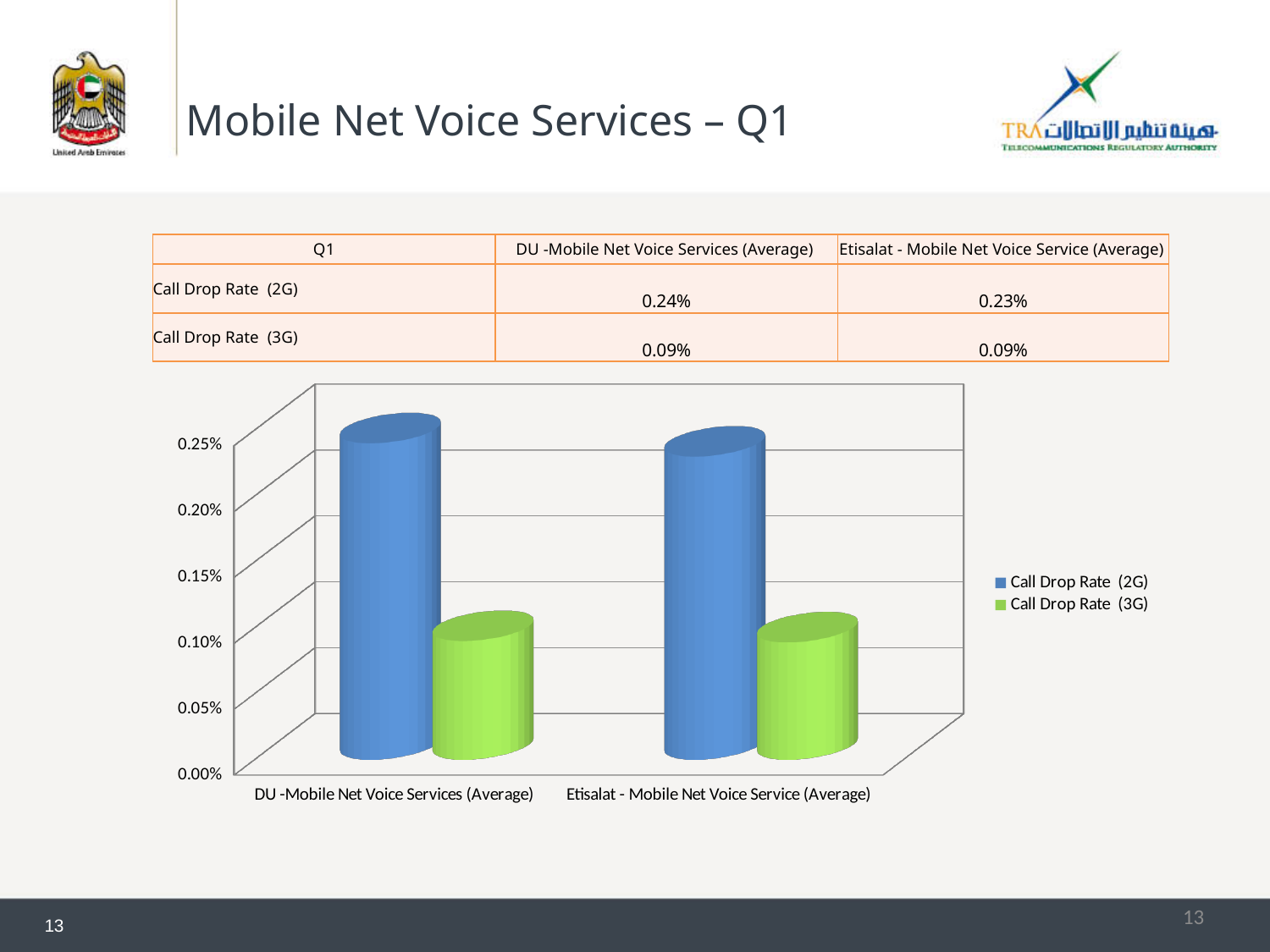
What is the difference between the Call Drop Rate (2G) and Call Drop Rate (3G) for Etisalat - Mobile Net Voice Service (Average)? 0.14% What kind of chart is shown on the slide? Bar chart What is the Call Drop Rate (3G) for DU - Mobile Net Voice Services (Average)? 0.09% For Etisalat - Mobile Net Voice Service (Average), which is larger: Call Drop Rate (2G) or Call Drop Rate (3G)? Call Drop Rate (2G) What is the Call Drop Rate (2G) for DU - Mobile Net Voice Services (Average)? 0.24% Is the Call Drop Rate (2G) for DU - Mobile Net Voice Services (Average) greater or less than 0.20%? greater How many series does the chart legend list? 2 Is the Call Drop Rate (3G) for Etisalat - Mobile Net Voice Service (Average) greater or less than 0.15%? less What is the Call Drop Rate (2G) for Etisalat - Mobile Net Voice Service (Average)? 0.23% What is the difference between the Call Drop Rate (2G) and Call Drop Rate (3G) for DU - Mobile Net Voice Services (Average)? 0.15% Which series has the highest value for DU - Mobile Net Voice Services (Average)? Call Drop Rate (2G) What is the Call Drop Rate (3G) for Etisalat - Mobile Net Voice Service (Average)? 0.09%